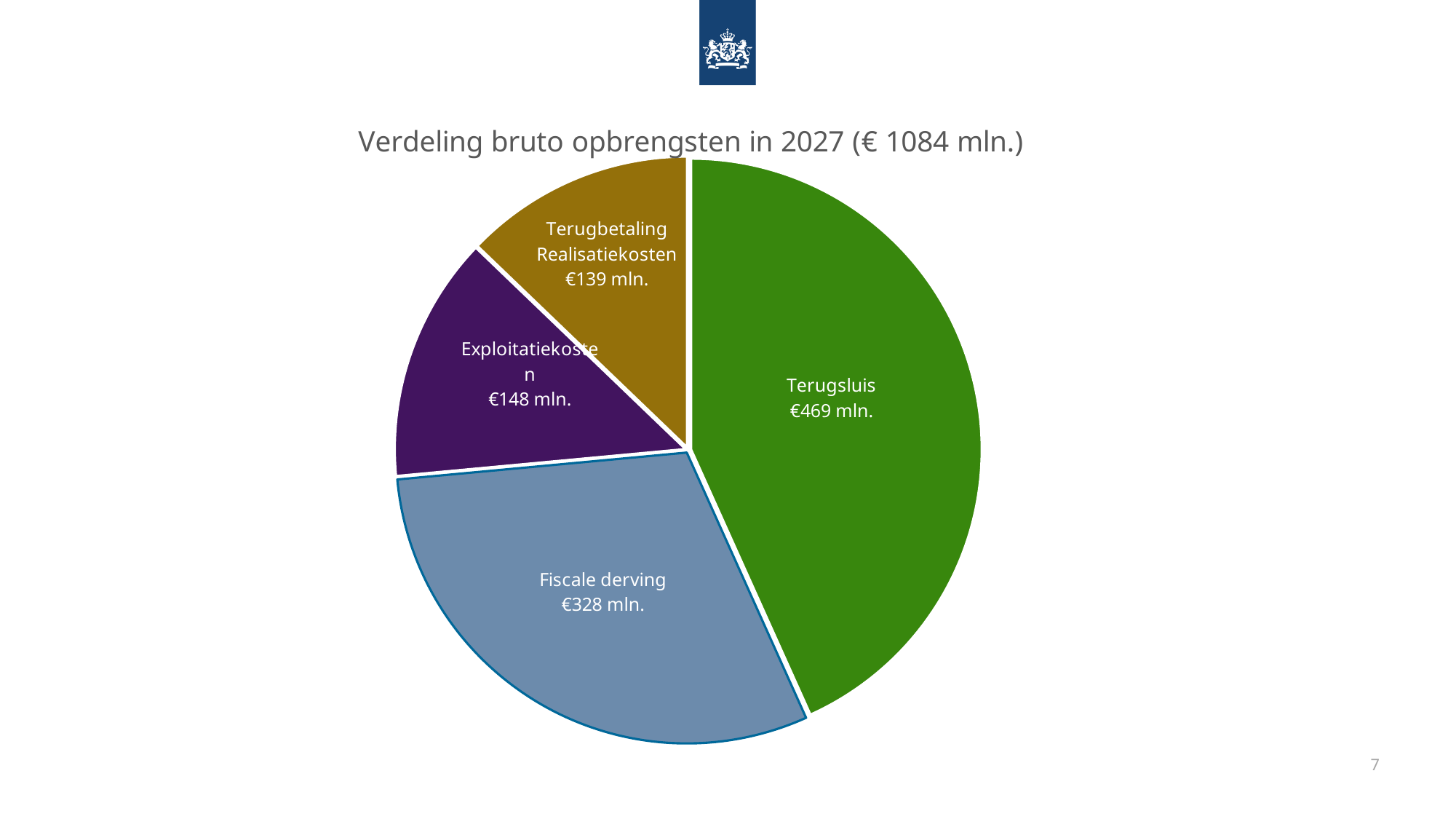
What is the value for Terugsluis? €469 mln. What is the difference between the values for Terugsluis and Fiscale derving? €141 mln. What is the value for Exploitatiekosten? €148 mln. What is the difference between the values for Exploitatiekosten and Terugbetaling Realisatiekosten? €9 mln. Which category has the largest slice of the pie? Terugsluis What is the title of the chart? Verdeling bruto opbrengsten in 2027 (€ 1084 mln.) What kind of chart is shown on the slide? Pie chart How many slices does the pie chart have? 4 What is the value for Fiscale derving? €328 mln. Which category has the smallest slice of the pie? Terugbetaling Realisatiekosten Which is larger, the value for Exploitatiekosten or the value for Terugbetaling Realisatiekosten? Exploitatiekosten What is the value for Terugbetaling Realisatiekosten? €139 mln.